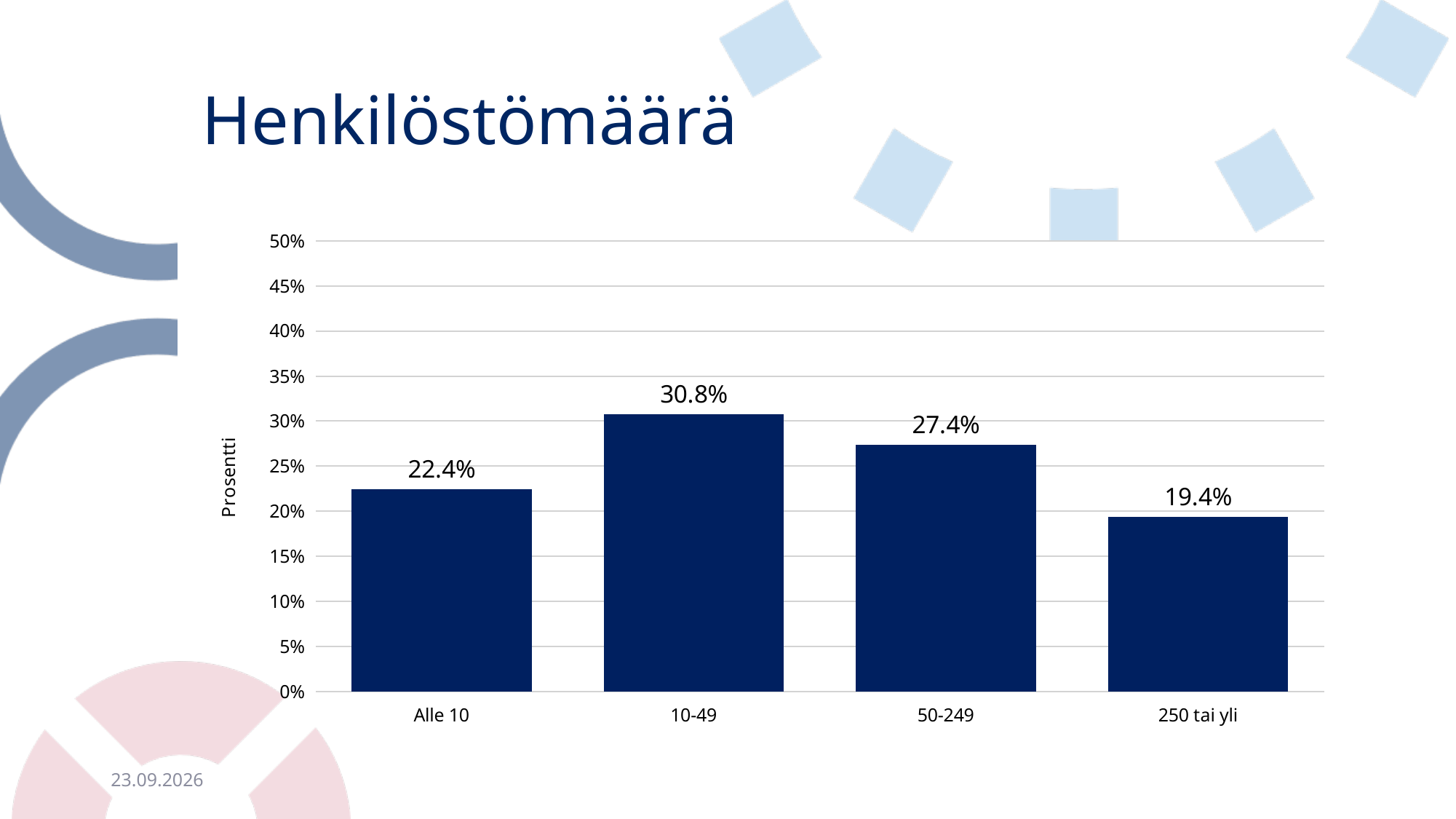
What is the value for the "Alle 10" category? 22.4% What kind of chart is shown on the slide? Bar chart Which category has the highest value? 10-49 What is the label of the vertical axis? Prosentti What is the difference between the values for "Alle 10" and "250 tai yli"? 3.0% Which category has the lowest value? 250 tai yli What is the value for the "10-49" category? 30.8% Is the value for "50-249" greater or less than 25%? greater Which is larger, the value for "Alle 10" or the value for "50-249"? 50-249 What is the value for the "250 tai yli" category? 19.4% How many categories are shown on the x axis? 4 What is the difference between the values for "10-49" and "50-249"? 3.4%